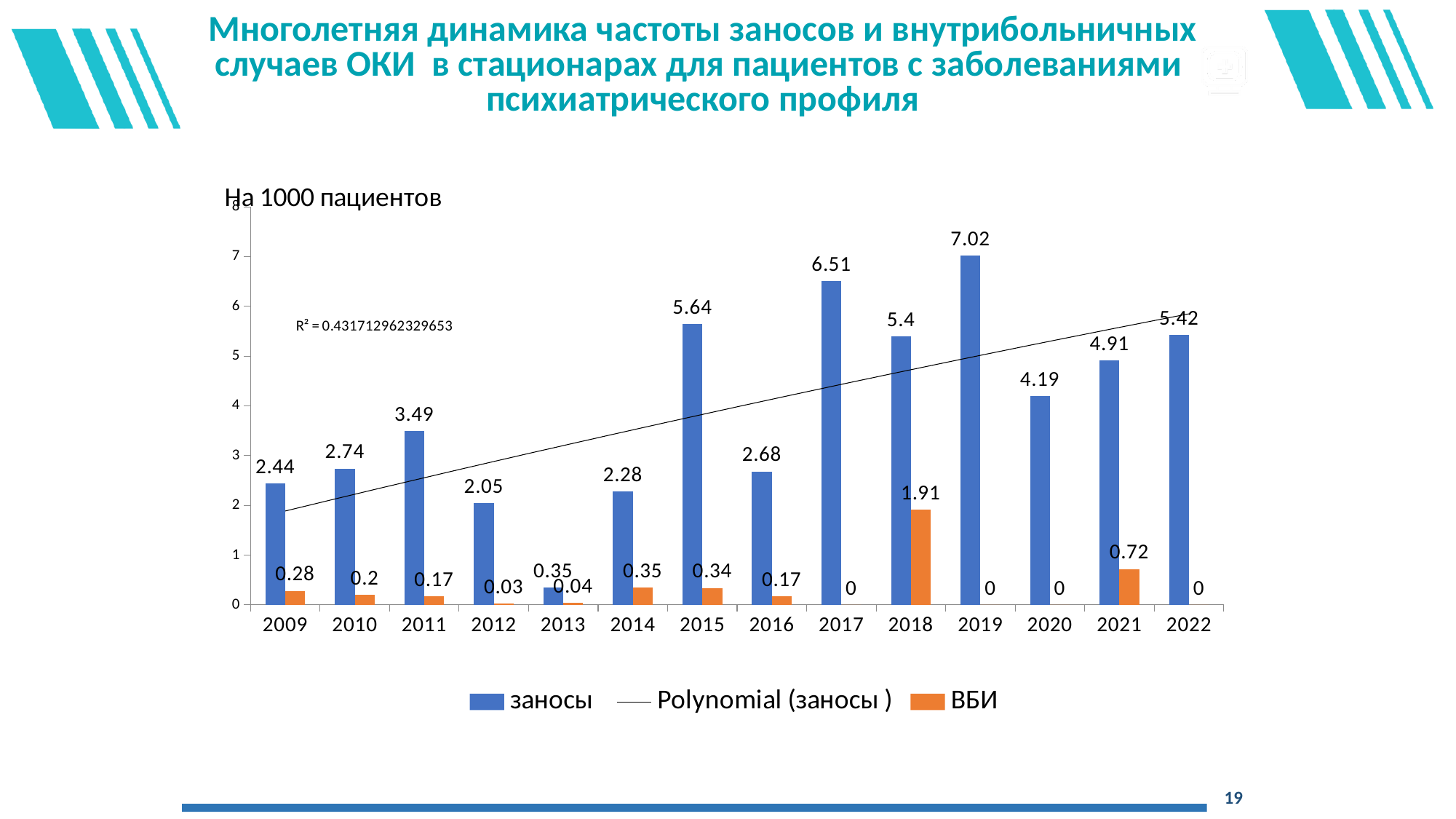
Which is larger, the заносы value for 2015 or for 2022? 2015 What is the R² value printed on the chart? 0.431712962329653 What is the value of заносы for 2019? 7.02 What kind of chart is shown on the slide? Bar chart How many years are shown on the x axis? 14 Which year has the highest value of ВБИ? 2018 Which year has the highest value of заносы? 2019 How many entries does the legend list? 3 What is the value of заносы for 2013? 0.35 What is the difference between the заносы values for 2019 and 2020? 2.83 Which year has the lowest value of заносы? 2013 What is the value of ВБИ for 2018? 1.91